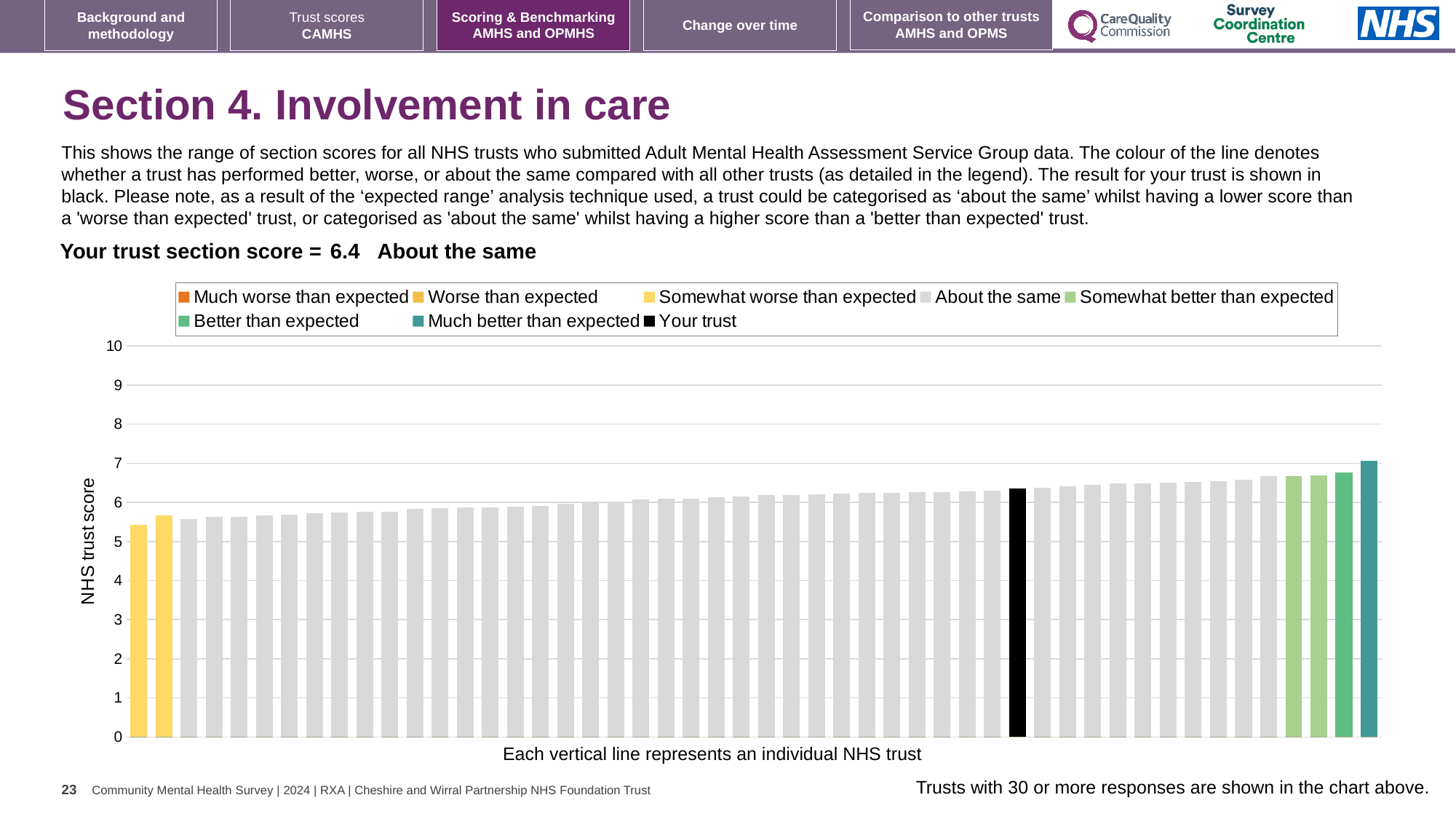
What kind of chart is shown on the slide? bar chart Is your trust's bar higher or lower than the leftmost bar in the chart? higher Is the score of the lowest-scoring trust greater or less than 6? less What is the label on the vertical axis of the chart? NHS trust score Which legend category does the highest-scoring trust belong to? Much better than expected Is your trust's score greater or less than 6? greater Is the score of the lowest-scoring trust greater or less than 5? greater Which comparison category is your trust placed in for this section? About the same What is your trust's section score for Involvement in care? 6.4 How many entries does the chart legend list? 8 Do the trust scores rise or fall from left to right across the chart? rise